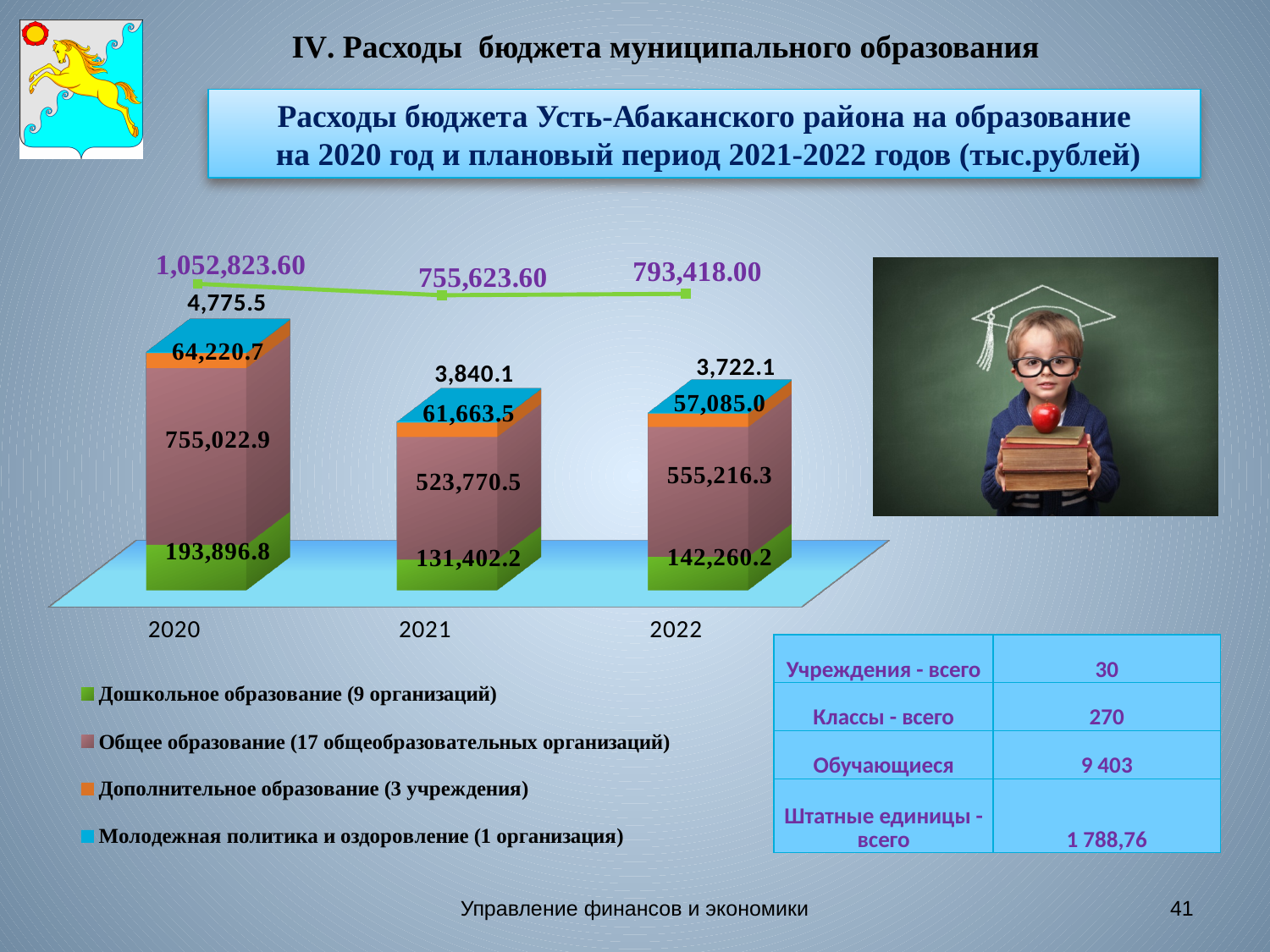
Does the value for Молодежная политика и оздоровление rise or fall from 2020 to 2022? fall What is the value for Дополнительное образование in 2022? 57,085.0 What is the value for Дошкольное образование in 2020? 193,896.8 By how much does Общее образование in 2022 exceed Общее образование in 2021? 31,445.8 How many series does the chart legend list? 4 In which year is the value for Общее образование the highest? 2020 What is the value for Общее образование in 2021? 523,770.5 What value is printed on the line above the 2020 bar? 1,052,823.60 How many years are shown on the x axis of the chart? 3 Which is larger: Дополнительное образование in 2020 or in 2021? 2020 In which year is the value for Дошкольное образование the lowest? 2021 What is the value for Молодежная политика и оздоровление in 2020? 4,775.5